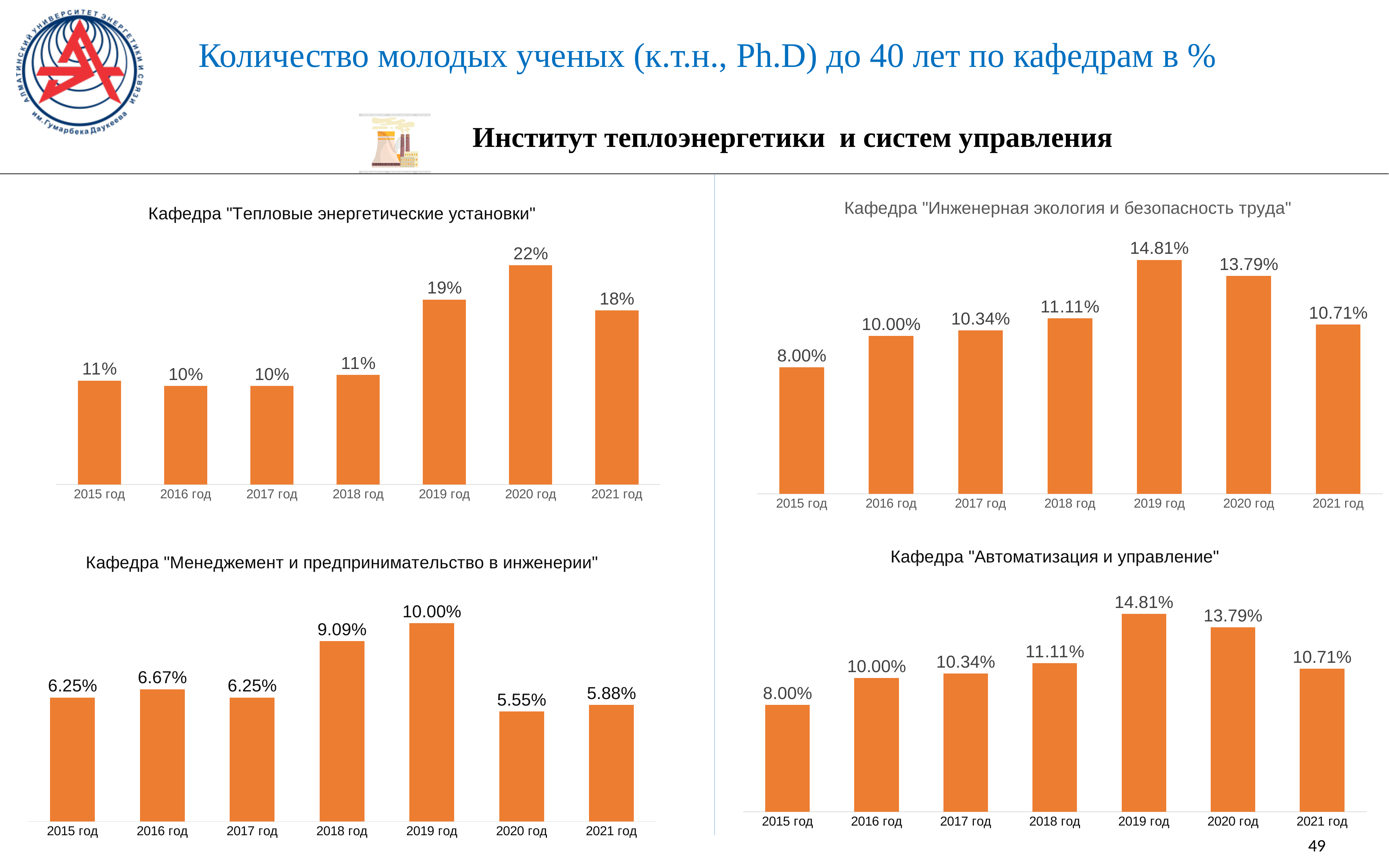
In the chart titled Кафедра "Менеджемент и предпринимательство в инженерии", what is the value for 2018 год? 9.09% In the chart titled Кафедра "Автоматизация и управление", what is the value for 2017 год? 10.34% What kind of chart is the chart titled Кафедра "Автоматизация и управление"? Bar chart In the chart titled Кафедра "Тепловые энергетические установки", which year has the highest value? 2020 год In the chart titled Кафедра "Менеджемент и предпринимательство в инженерии", how many years are shown on the x axis? 7 In the chart titled Кафедра "Автоматизация и управление", what is the difference between the values for 2019 год and 2020 год? 1.02% In the chart titled Кафедра "Тепловые энергетические установки", what is the value for 2020 год? 22% In the chart titled Кафедра "Инженерная экология и безопасность труда", what is the value for 2019 год? 14.81% In the chart titled Кафедра "Менеджемент и предпринимательство в инженерии", which year has the lowest value? 2020 год In the chart titled Кафедра "Тепловые энергетические установки", what is the difference between the values for 2020 год and 2021 год? 4% In the chart titled Кафедра "Инженерная экология и безопасность труда", which year has the lowest value? 2015 год In the chart titled Кафедра "Инженерная экология и безопасность труда", which is larger, the value for 2020 год or 2021 год? 2020 год